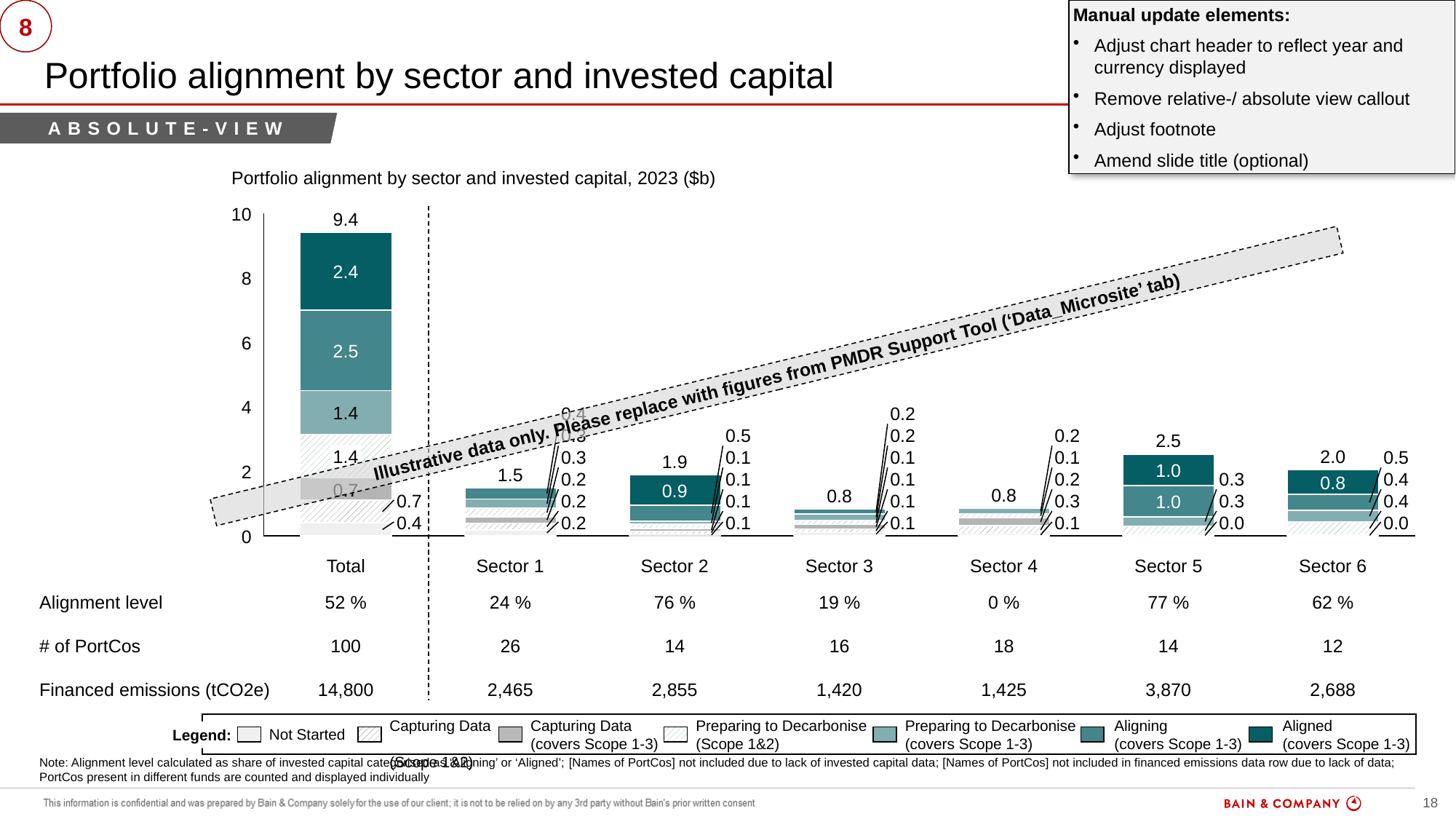
What is the value of the Aligned (covers Scope 1-3) segment for Sector 2? 0.9 What is the value of the Aligned (covers Scope 1-3) segment for Sector 5? 1.0 What is the difference between the bar totals of Sector 5 and Sector 6? 0.5 What is the value of the Aligned (covers Scope 1-3) segment in the Total bar? 2.4 How many series does the legend list? 7 What is the value of the Aligning (covers Scope 1-3) segment in the Total bar? 2.5 What is the total value of the Total bar? 9.4 Is the value of the Total bar greater or less than 8? greater What kind of chart is shown on the slide? Stacked bar chart Which has a larger bar total, Sector 5 or Sector 6? Sector 5 How many categories are shown on the x axis? 7 Among Sector 1 to Sector 6, which sector has the highest bar total? Sector 5